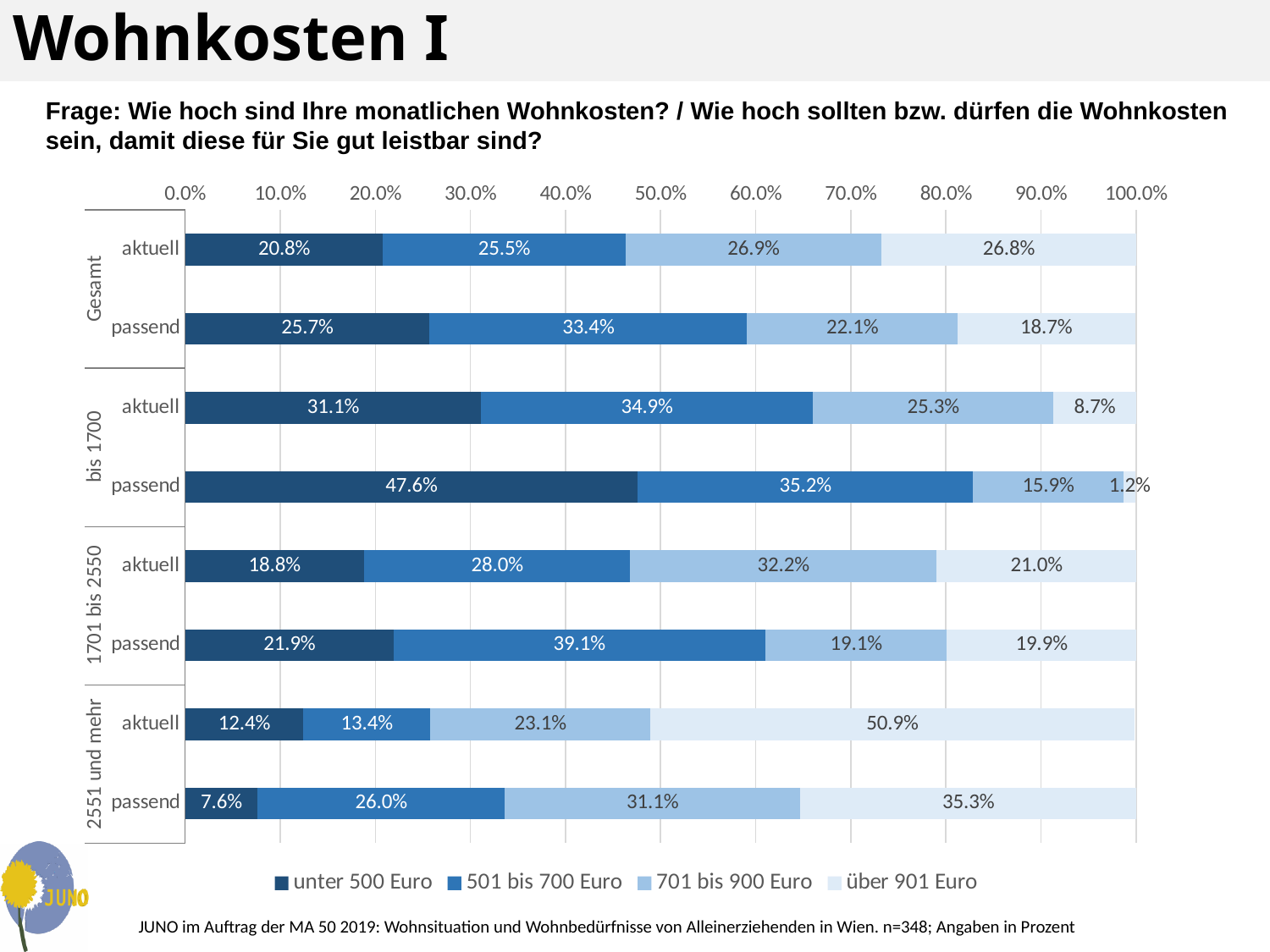
How many bars are plotted in the chart? 8 How many series does the legend list? 4 What kind of chart is shown on the slide? Stacked bar chart Which bar has the largest 'unter 500 Euro' segment? bis 1700 – passend What is the first entry in the chart legend? unter 500 Euro Which bar has the smallest 'unter 500 Euro' segment? 2551 und mehr – passend What is the difference between the '501 bis 700 Euro' segments of 'Gesamt – passend' and 'Gesamt – aktuell'? 7.9 percentage points In the '1701 bis 2550 – aktuell' bar, which segment is larger: '701 bis 900 Euro' or '501 bis 700 Euro'? 701 bis 900 Euro What is the value of the 'über 901 Euro' segment for 'bis 1700 – passend'? 1.2% What is the value of the '501 bis 700 Euro' segment for '1701 bis 2550 – passend'? 39.1% What is the value of the 'unter 500 Euro' segment for 'Gesamt – aktuell'? 20.8% What is the value of the 'über 901 Euro' segment for '2551 und mehr – aktuell'? 50.9%